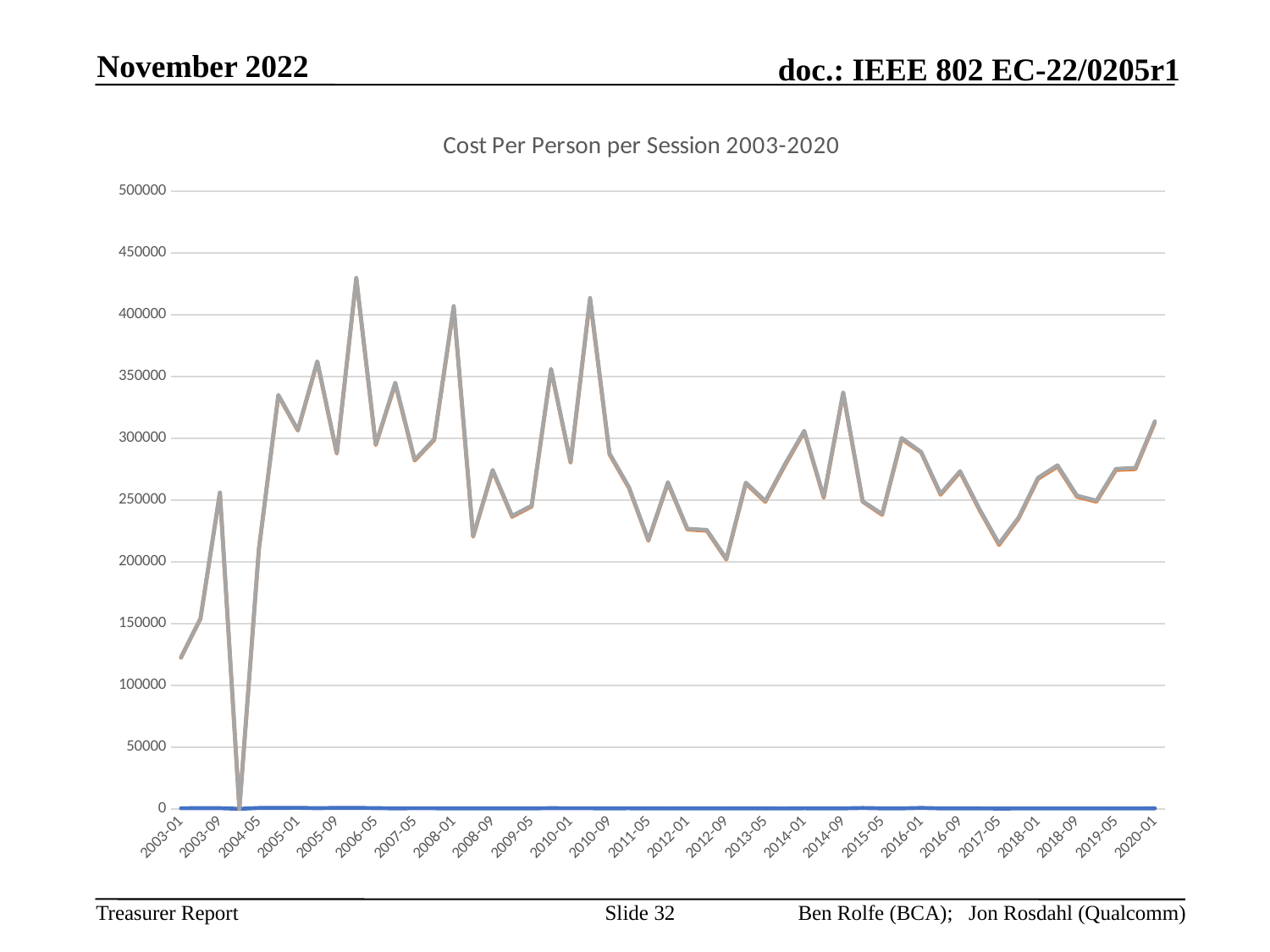
Which has the larger value, 2003-01 or 2020-01? 2020-01 Is the value for 2004-05 greater or less than 50000? greater What is the title of the chart? Cost Per Person per Session 2003-2020 Is the value for 2012-09 greater or less than 250000? less Which of the labelled sessions has the lowest cost per person? 2003-01 What kind of chart is shown on the slide? line chart What is the highest value shown on the vertical axis of the chart? 500000 Is the value for 2008-01 greater or less than 350000? greater Which has the larger value, 2008-01 or 2012-09? 2008-01